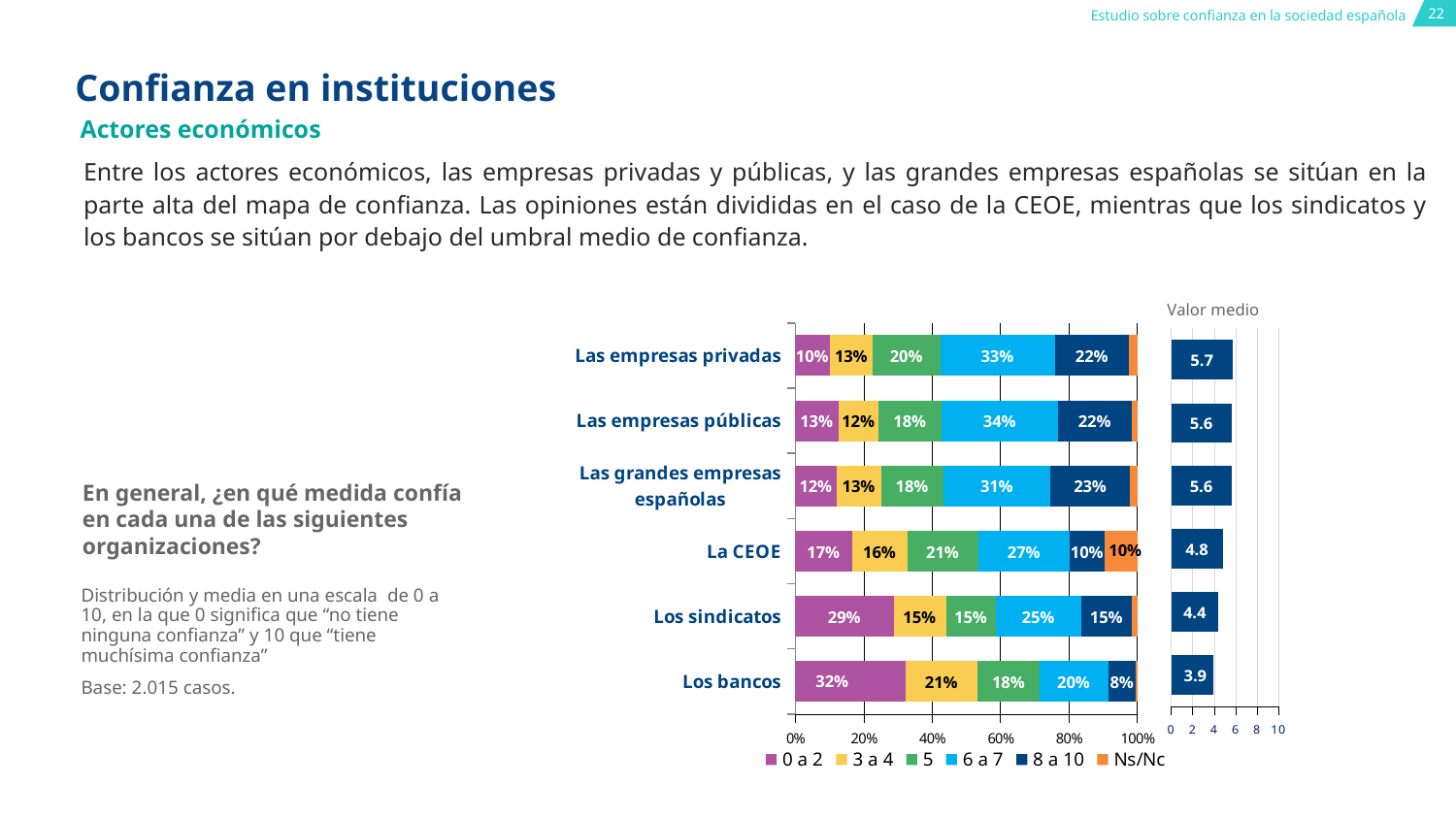
How many organizations are shown in the stacked bar chart? 6 How many series does the legend of the stacked bar chart list? 6 What kind of chart is used to show the distribution of confidence scores by organization? Stacked bar chart In the 'Valor medio' chart, which organization has the lowest mean score? Los bancos What is the title of the small chart to the right of the stacked bars? Valor medio In the stacked bar chart, what percentage of respondents gave 'Los bancos' a score of 0 a 2? 32% In the 'Valor medio' chart, what is the mean score for 'La CEOE'? 4.8 In the stacked bar chart, which organization has the largest share of '0 a 2' responses? Los bancos In the stacked bar chart, what is the difference between the '8 a 10' share for 'Las grandes empresas españolas' and for 'Los bancos'? 15 percentage points In the stacked bar chart, what percentage of respondents gave 'Las empresas públicas' a score of 6 a 7? 34% In the stacked bar chart, which is larger: the '6 a 7' share for 'Las empresas privadas' or for 'Los sindicatos'? Las empresas privadas In the 'Valor medio' chart, which organization has the highest mean score? Las empresas privadas